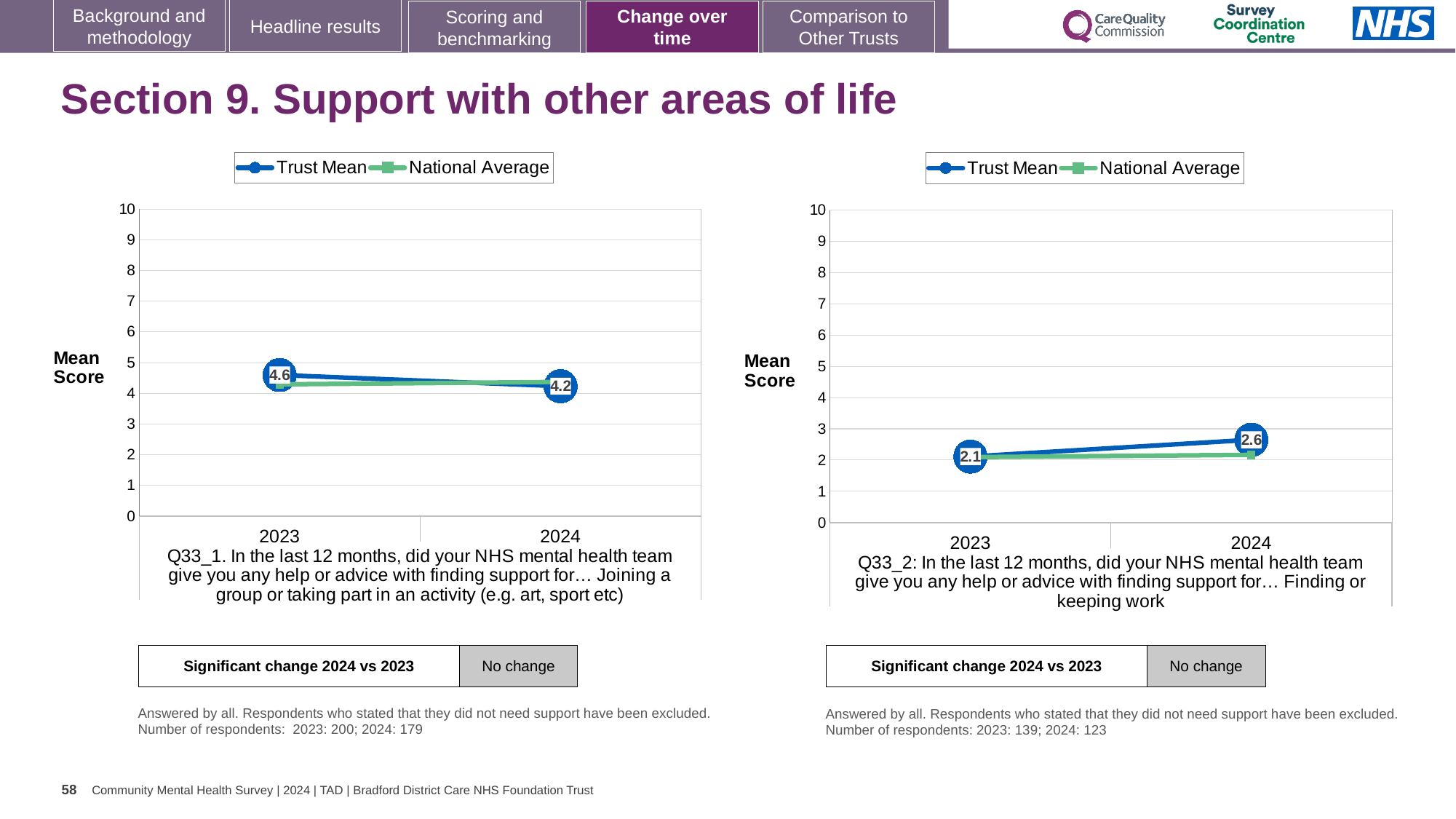
In the left chart (Q33_1), what is the Trust Mean for 2023? 4.6 How many series does the legend of the right chart (Q33_2) list? 2 In the right chart (Q33_2), by how much did the Trust Mean change from 2023 to 2024? 0.5 In the right chart (Q33_2), what is the Trust Mean for 2023? 2.1 In the right chart (Q33_2), does the Trust Mean rise or fall from 2023 to 2024? rise In the right chart (Q33_2), what is the Trust Mean for 2024? 2.6 In the left chart (Q33_1), what is the Trust Mean for 2024? 4.2 In the left chart (Q33_1), does the Trust Mean rise or fall from 2023 to 2024? fall In the left chart (Q33_1), by how much did the Trust Mean change from 2023 to 2024? 0.4 What kind of chart is the left chart (Q33_1)? line chart In the right chart (Q33_2), which is larger in 2024, the Trust Mean or the National Average? Trust Mean In the right chart (Q33_2), is the National Average for 2024 greater or less than 3? less